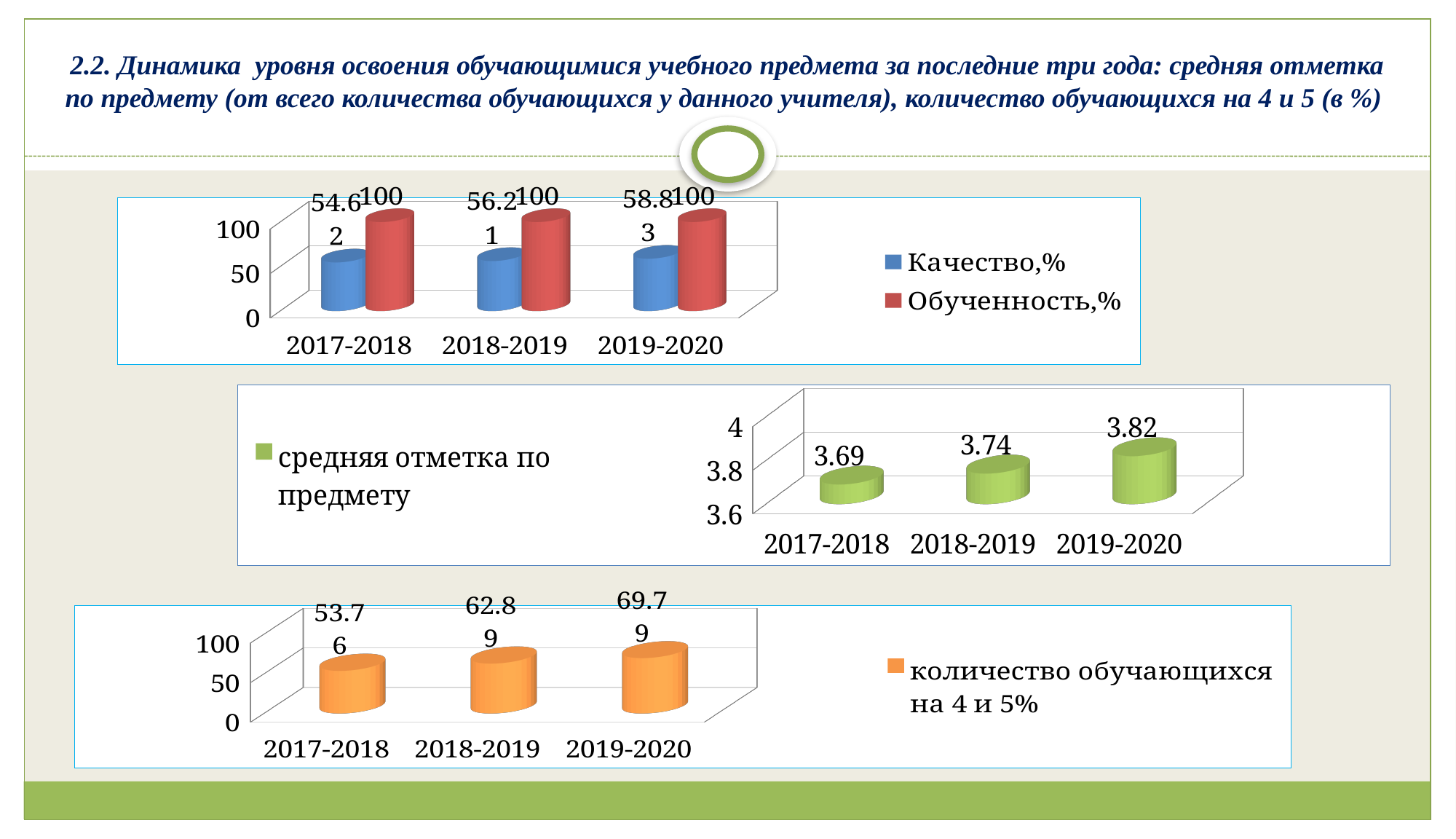
In the bottom chart (количество обучающихся на 4 и 5%), how many year categories are shown on the x axis? 3 What kind of chart is the bottom chart (количество обучающихся на 4 и 5%)? bar chart In the top chart, what is the value of Обученность,% for 2018-2019? 100 In the middle chart (средняя отметка по предмету), which year has the highest value? 2019-2020 In the middle chart (средняя отметка по предмету), which year has the lowest value? 2017-2018 In the middle chart (средняя отметка по предмету), what is the value for 2017-2018? 3.69 In the middle chart (средняя отметка по предмету), do the values rise or fall from 2017-2018 to 2019-2020? rise In the bottom chart (количество обучающихся на 4 и 5%), is the value for 2019-2020 greater or less than 50? greater In the middle chart (средняя отметка по предмету), what is the difference between the 2019-2020 and 2017-2018 values? 0.13 In the middle chart (средняя отметка по предмету), what is the value for 2019-2020? 3.82 In the top chart, how many series does the legend list? 2 In the top chart, which is larger for 2019-2020: Качество,% or Обученность,%? Обученность,%